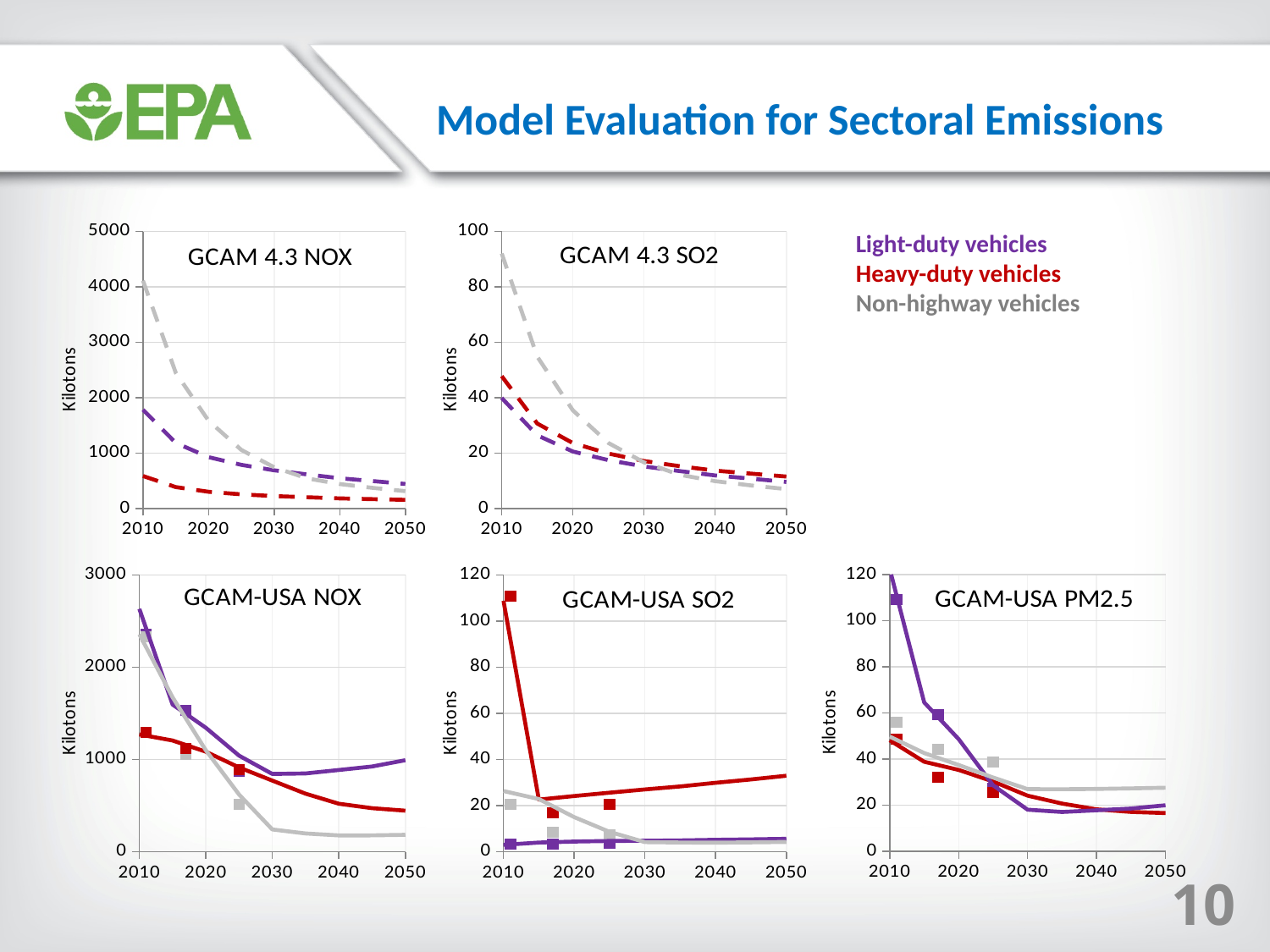
What kind of chart is the GCAM 4.3 NOX chart? line chart In the GCAM 4.3 NOX chart, which series has the highest value in 2010? Non-highway vehicles In the GCAM-USA SO2 chart, is the Heavy-duty vehicles line value in 2010 greater or less than 100? greater In the GCAM-USA PM2.5 chart, which series has the highest value in 2010? Light-duty vehicles In the GCAM 4.3 NOX chart, is the value for Non-highway vehicles in 2010 greater or less than 3000? greater How many series does the legend list for the charts on the slide? 3 In the GCAM 4.3 SO2 chart, is the value for Non-highway vehicles in 2010 greater or less than 80? greater In the GCAM-USA SO2 chart, does the Heavy-duty vehicles line rise or fall from 2020 to 2050? rise How many charts are shown on the slide? 5 What is the y-axis label on the GCAM-USA NOX chart? Kilotons In the GCAM 4.3 NOX chart, which series has the lowest value in 2010? Heavy-duty vehicles In the GCAM 4.3 NOX chart, do the Non-highway vehicles values rise or fall from 2010 to 2050? fall